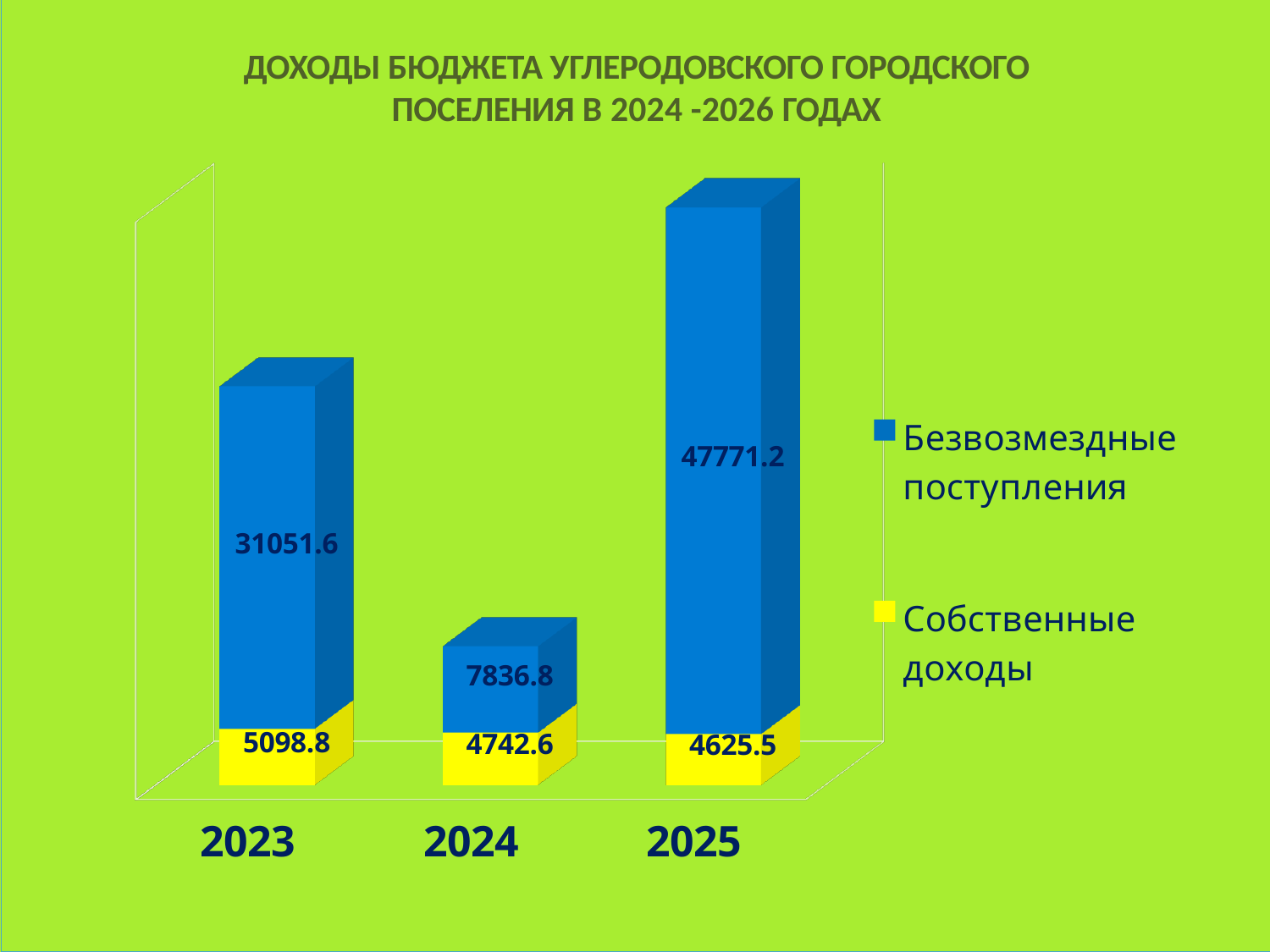
What is the difference between Собственные доходы in 2023 and in 2024? 356.2 What is the total of the stacked bar for 2024? 12579.4 What is the value of Безвозмездные поступления for 2025? 47771.2 What is the difference between Безвозмездные поступления in 2025 and in 2023? 16719.6 In which year is Безвозмездные поступления the highest? 2025 Do the values of Собственные доходы rise or fall from 2023 to 2025? fall How many series does the legend list? 2 What is the total of the stacked bar for 2025? 52396.7 What is the value of Безвозмездные поступления for 2023? 31051.6 In which year is Безвозмездные поступления the lowest? 2024 What is the value of Собственные доходы for 2024? 4742.6 Which is larger: Собственные доходы in 2023 or in 2025? 2023